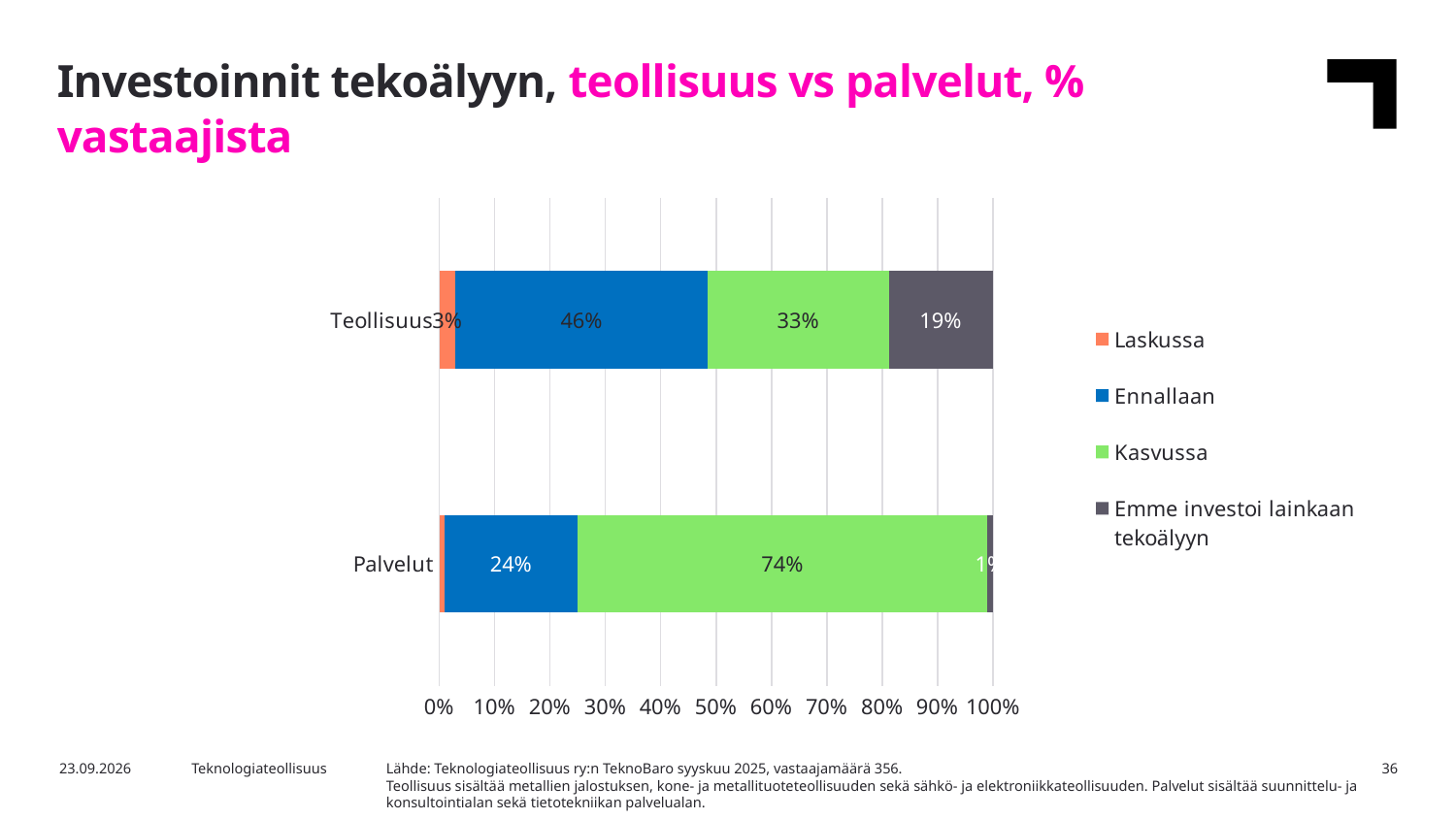
What is the value of Laskussa for Teollisuus? 3% What is the value of Kasvussa for Teollisuus? 33% What is the value of Ennallaan for Palvelut? 24% How many series does the legend list? 4 What is the difference in percentage points between the Kasvussa values for Palvelut and Teollisuus? 41 percentage points What is the value of Emme investoi lainkaan tekoälyyn for Teollisuus? 19% What kind of chart is shown on the slide? Stacked bar chart Which series has the largest share in the Teollisuus bar? Ennallaan How many categories (bars) does the chart show? 2 Which category has the larger Kasvussa share, Teollisuus or Palvelut? Palvelut What is the value of Ennallaan for Teollisuus? 46% What is the value of Kasvussa for Palvelut? 74%